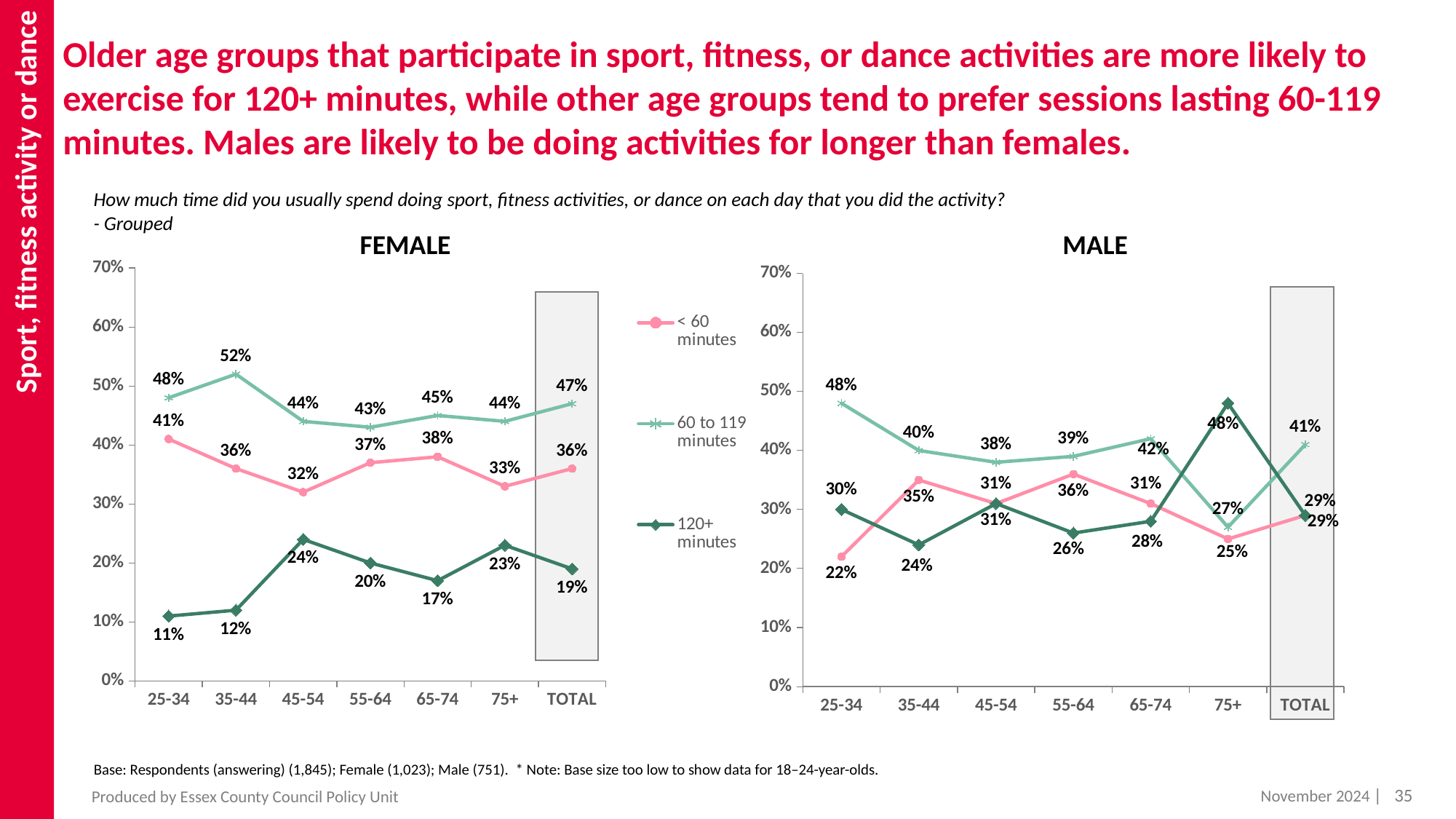
In the MALE chart, what is the difference between the 120+ minutes values for 75+ and 65-74? 20 percentage points What is the title of the chart on the right? MALE In the FEMALE chart, what percentage of females aged 35-44 spent 60 to 119 minutes on the activity? 52% In the MALE chart, which age group has the highest value for the 60 to 119 minutes series? 25-34 What kind of chart is the FEMALE chart? Line chart How many series does the legend list? 3 In the MALE chart, which is larger for the 55-64 age group: the < 60 minutes value or the 120+ minutes value? < 60 minutes How many categories are shown on the x axis of the MALE chart? 7 In the FEMALE chart, is the value for 120+ minutes in the 45-54 age group greater or less than 20%? greater In the FEMALE chart, what is the difference between the TOTAL values for 60 to 119 minutes and < 60 minutes? 11 percentage points In the MALE chart, what percentage of males aged 75+ spent 120+ minutes on the activity? 48% In the FEMALE chart, which age group has the lowest value for the 120+ minutes series? 25-34